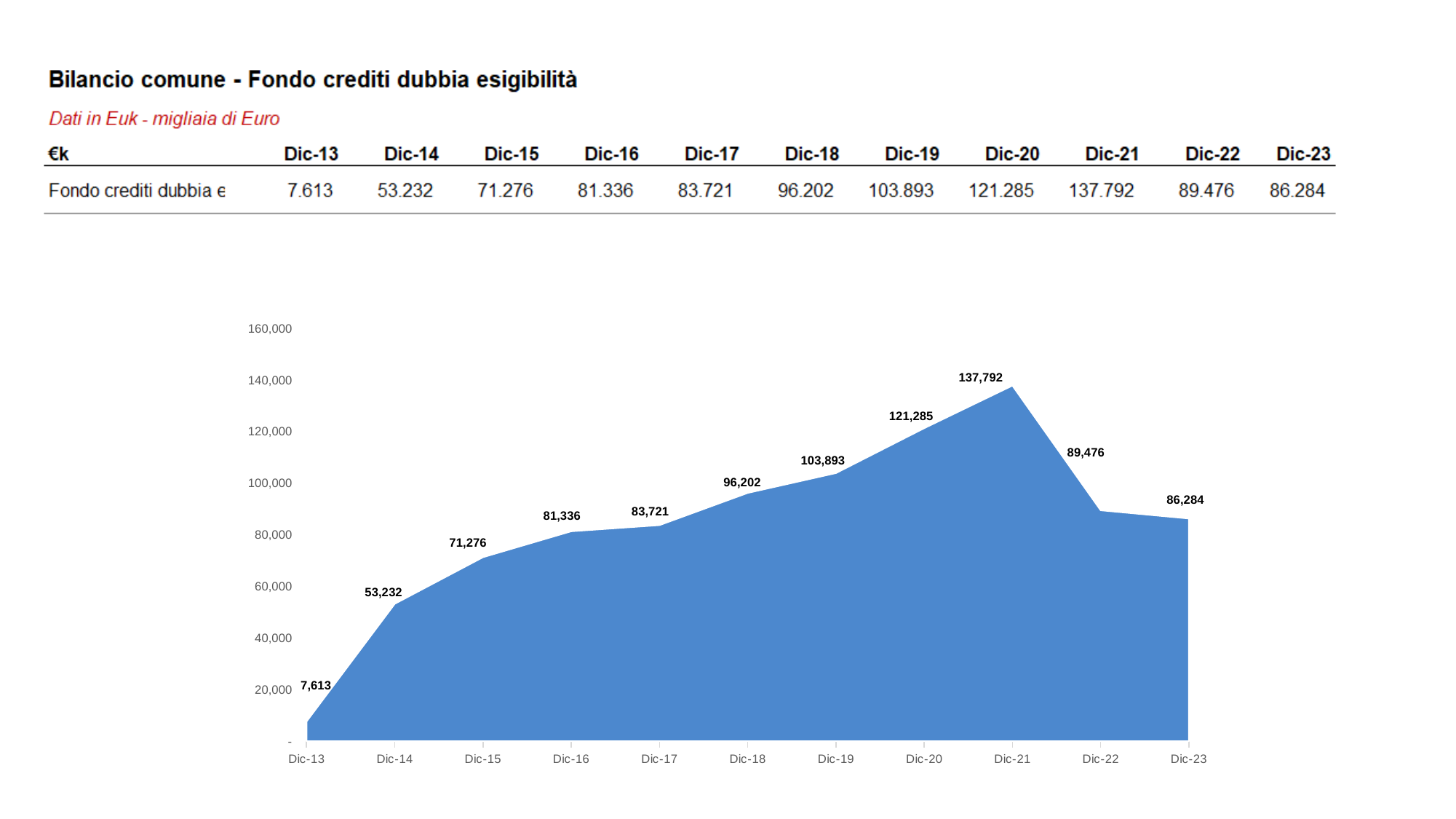
What kind of chart is shown on the slide? area chart How many periods are plotted on the x axis of the chart? 11 Which is larger, the value for Dic-19 or the value for Dic-22? Dic-19 What is the value for Dic-23 in the chart? 86,284 Which period has the lowest value in the chart? Dic-13 What is the difference between the values for Dic-21 and Dic-22? 48,316 What is the value for Dic-13 in the chart? 7,613 What is the value for Dic-21 in the chart? 137,792 Is the value for Dic-20 greater or less than 100,000? greater Do the values rise or fall from Dic-13 to Dic-21? rise Which period has the highest value in the chart? Dic-21 What is the title of the slide above the chart? Bilancio comune - Fondo crediti dubbia esigibilità